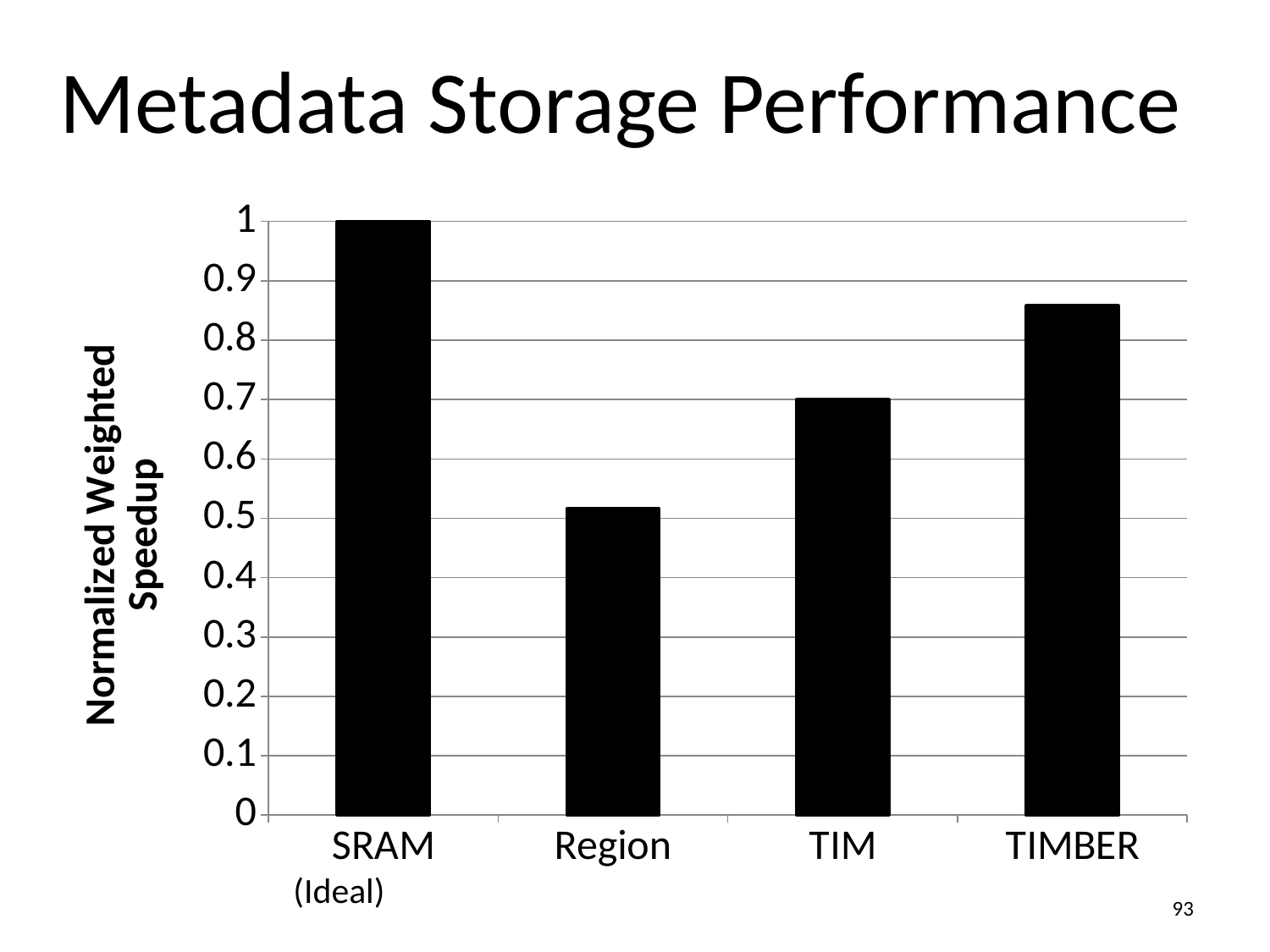
Is the value for TIMBER greater or less than 0.9? less What kind of chart is shown on the slide? bar chart How many categories are plotted on the x axis? 4 Which category has the lowest normalized weighted speedup? Region Which has a larger normalized weighted speedup, Region or TIM? TIM Is the value for Region greater or less than 0.6? less Is the value for TIMBER greater or less than 0.8? greater What is the label of the y axis? Normalized Weighted Speedup Which has a larger normalized weighted speedup, TIM or TIMBER? TIMBER Which category has the highest normalized weighted speedup? SRAM (Ideal) What is the normalized weighted speedup for SRAM (Ideal)? 1